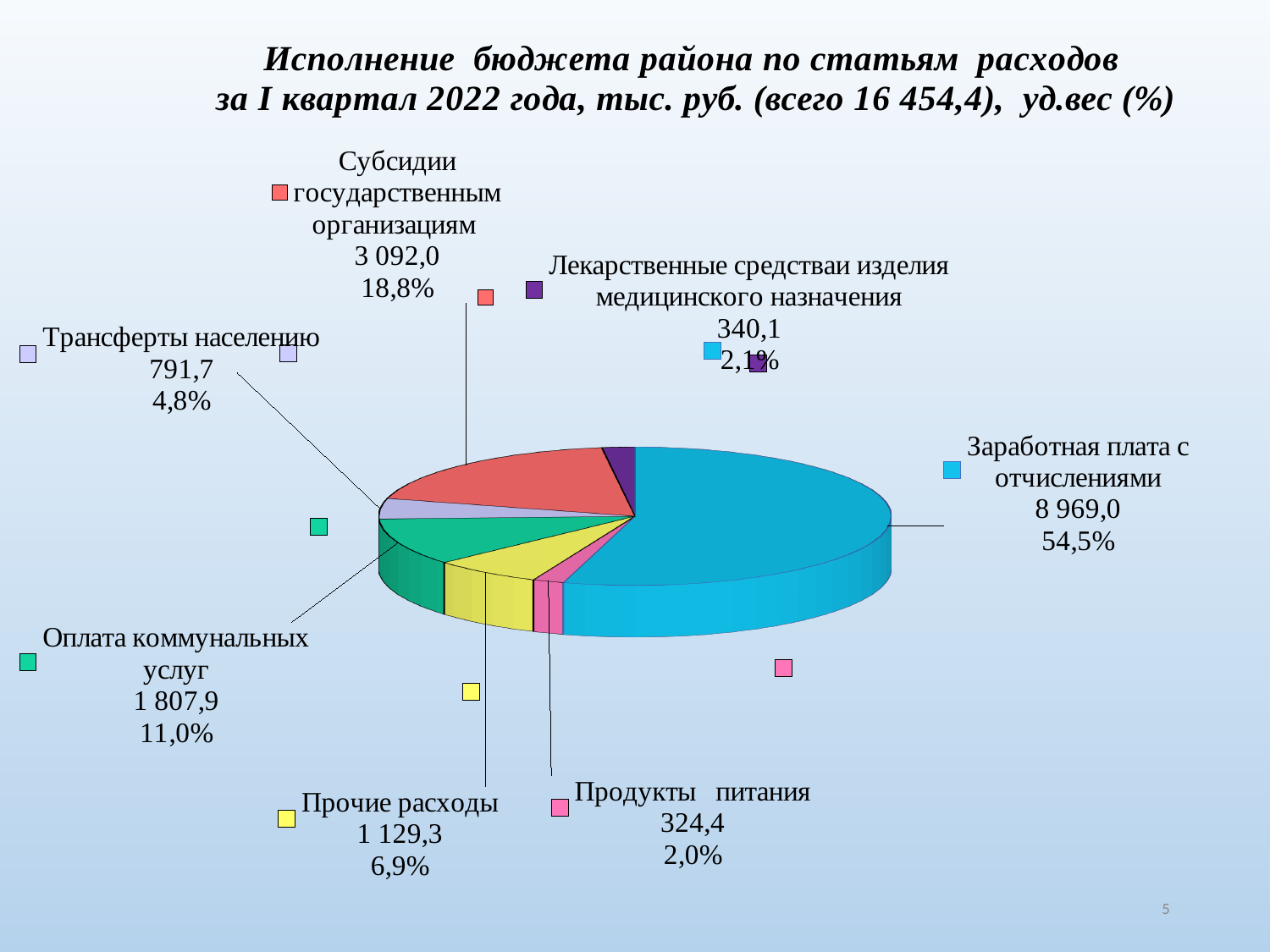
What is the value for «Лекарственные средства и изделия медицинского назначения»? 340,1 What total amount (всего) is stated in the chart title? 16 454,4 Which category has the largest share of the pie? Заработная плата с отчислениями What percentage is shown for «Прочие расходы»? 6,9% Which is larger: «Трансферты населению» or «Прочие расходы»? Прочие расходы What type of chart is shown on the slide? pie chart What is the value for «Заработная плата с отчислениями»? 8 969,0 What is the value for «Оплата коммунальных услуг»? 1 807,9 What is the difference between the values for «Субсидии государственным организациям» and «Оплата коммунальных услуг»? 1 284,1 Which category has the smallest value? Продукты питания What share of the pie does «Субсидии государственным организациям» have? 18,8% How many categories (slices) does the pie chart show? 7